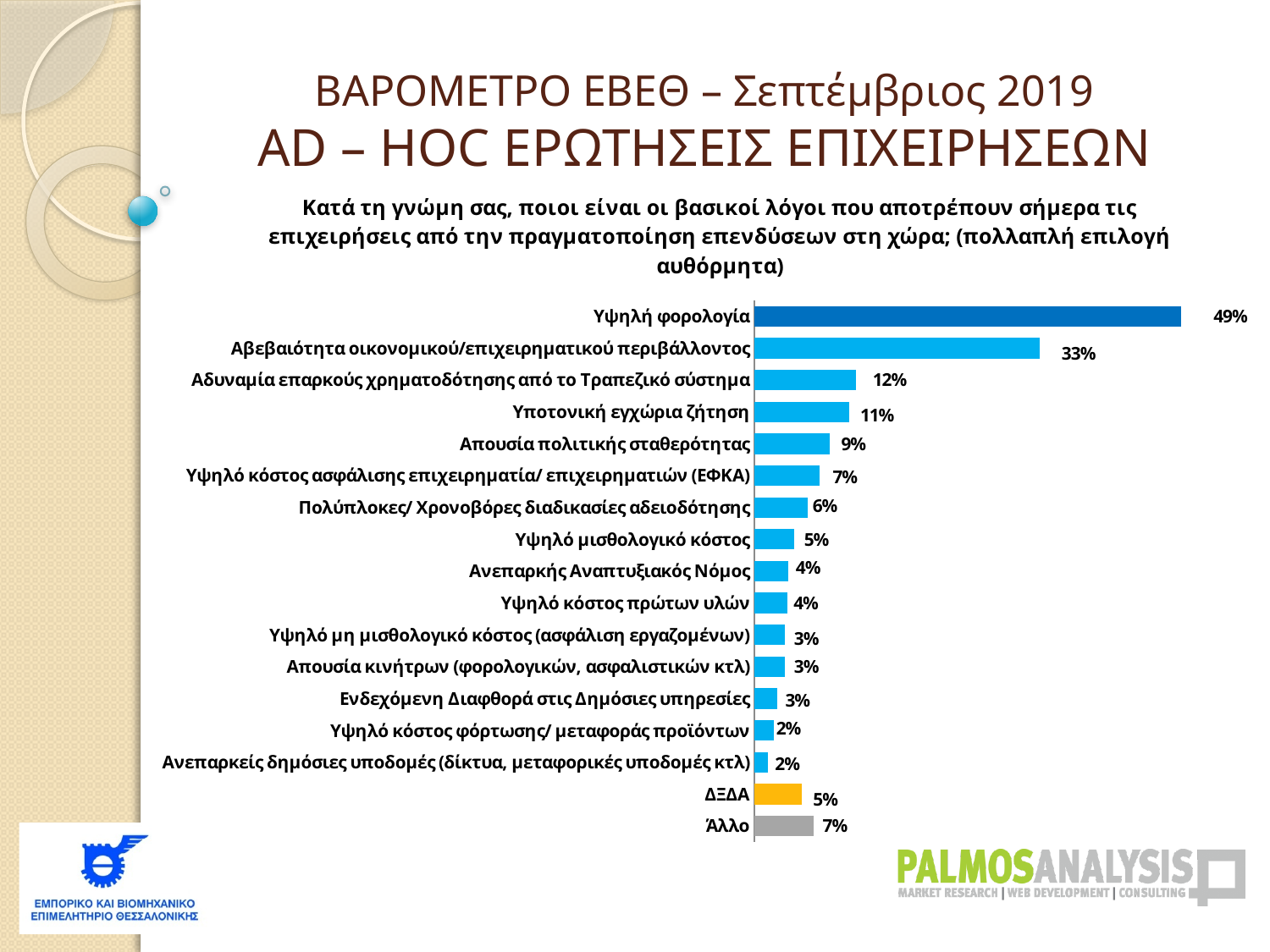
What is the difference between the values for Υψηλή φορολογία and Αβεβαιότητα οικονομικού/επιχειρηματικού περιβάλλοντος? 16% Which is larger, the value for Υψηλό κόστος ασφάλισης επιχειρηματία/ επιχειρηματιών (ΕΦΚΑ) or the value for Υψηλό μισθολογικό κόστος? Υψηλό κόστος ασφάλισης επιχειρηματία/ επιχειρηματιών (ΕΦΚΑ) What is the value for Υψηλή φορολογία? 49% Which category has the highest value? Υψηλή φορολογία What is the difference between the values for Αδυναμία επαρκούς χρηματοδότησης από το Τραπεζικό σύστημα and Απουσία πολιτικής σταθερότητας? 3% What is the value for Αβεβαιότητα οικονομικού/επιχειρηματικού περιβάλλοντος? 33% What is the value for ΔΞΔΑ? 5% What is the value for Άλλο? 7% How many categories are shown in the chart? 17 Which bar is shown in orange? ΔΞΔΑ What kind of chart is shown on the slide? Bar chart What is the value for Υποτονική εγχώρια ζήτηση? 11%